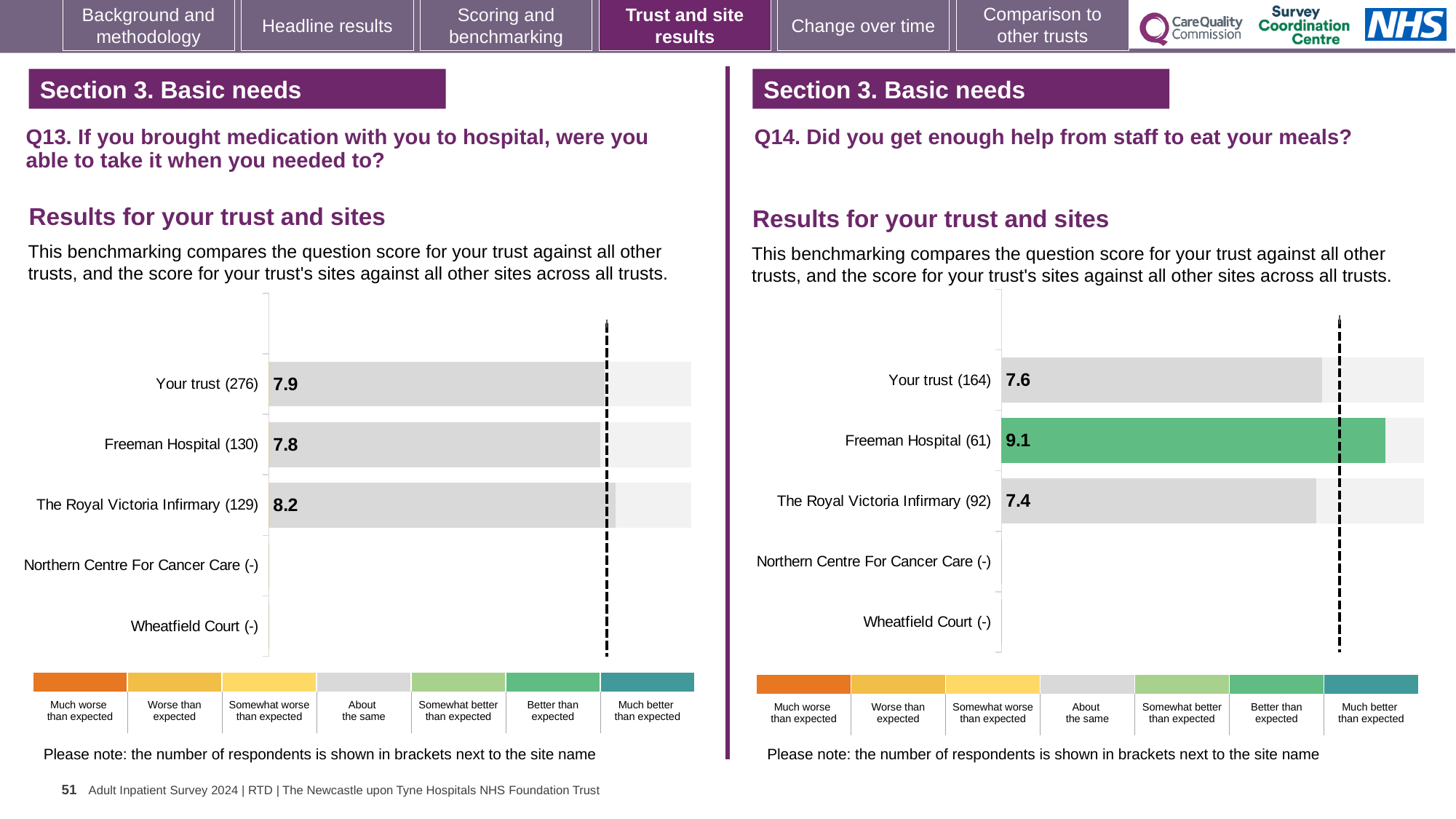
On the Q14 chart (right), what is the difference between the scores for Freeman Hospital and Your trust? 1.5 On the Q13 chart (left), what is the score for The Royal Victoria Infirmary? 8.2 On the Q14 chart (right), what is the score for The Royal Victoria Infirmary? 7.4 On the Q14 chart (right), what is the score for Freeman Hospital? 9.1 On the Q14 chart (right), which benchmark category does the colour of the Freeman Hospital bar correspond to? Better than expected What kind of chart is used on the Q13 chart (left)? Bar chart On the Q14 chart (right), which row has the lowest score? The Royal Victoria Infirmary On the Q13 chart (left), which site or trust row has the highest score? The Royal Victoria Infirmary On the Q13 chart (left), what is the score for Your trust? 7.9 On the Q14 chart (right), which has the larger score, Your trust or Freeman Hospital? Freeman Hospital How many respondents are shown in brackets for Your trust on the Q14 chart (right)? 164 On the Q13 chart (left), what is the difference between the scores for The Royal Victoria Infirmary and Freeman Hospital? 0.4